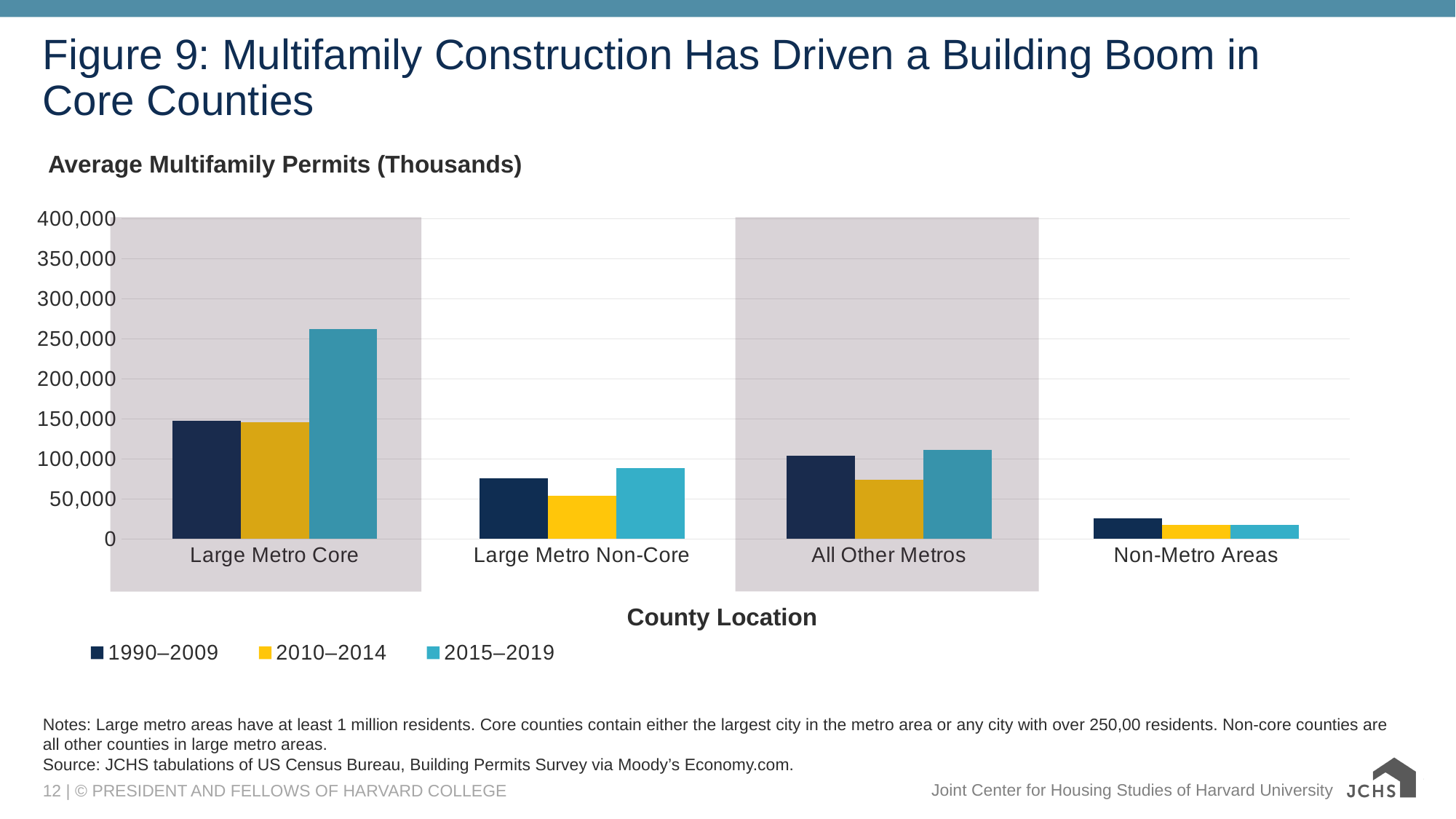
How many county location categories are shown on the x axis? 4 What type of chart is shown on the slide? bar chart How many series does the legend list? 3 For Large Metro Non-Core, which is larger: the value for 1990–2009 or the value for 2010–2014? 1990–2009 Is the value for Large Metro Core in 2015–2019 greater or less than 250,000? greater Is the value for Non-Metro Areas in 1990–2009 greater or less than 50,000? less What is the label of the x axis? County Location Which county location has the highest value for 2015–2019? Large Metro Core Is the value for Large Metro Non-Core in 2010–2014 greater or less than 100,000? less For All Other Metros, which is larger: the value for 2010–2014 or the value for 2015–2019? 2015–2019 Which county location has the lowest value for 1990–2009? Non-Metro Areas